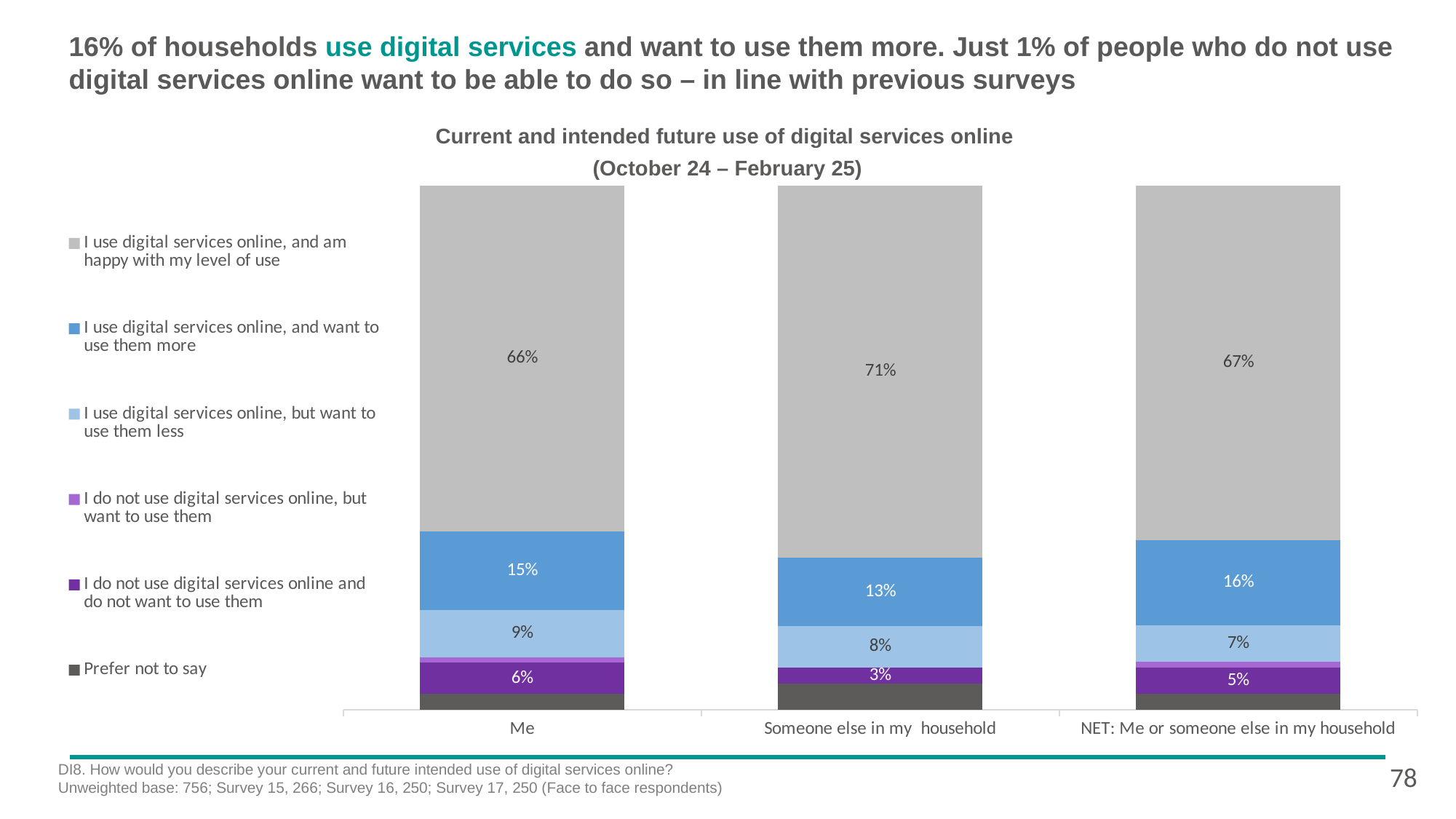
Which is larger: the 'want to use them more' value for 'Me' or for 'Someone else in my household'? Me Which category has the lowest value for 'I use digital services online, but want to use them less'? NET: Me or someone else in my household How many series does the legend list? 6 What is the value for 'I use digital services online, and want to use them more' in the 'NET: Me or someone else in my household' bar? 16% How many categories are shown on the x axis? 3 What is the difference between the 'happy with my level of use' values for 'Someone else in my household' and 'Me'? 5% What kind of chart is shown on the slide? Stacked bar chart Which category has the highest value for 'I use digital services online, and am happy with my level of use'? Someone else in my household What is the value for 'I do not use digital services online and do not want to use them' in the 'Someone else in my household' bar? 3% What is the value for 'I use digital services online, and want to use them more' in the 'Someone else in my household' bar? 13% What percentage of the 'Me' bar is 'I use digital services online, and am happy with my level of use'? 66% What is the title of the chart? Current and intended future use of digital services online (October 24 – February 25)